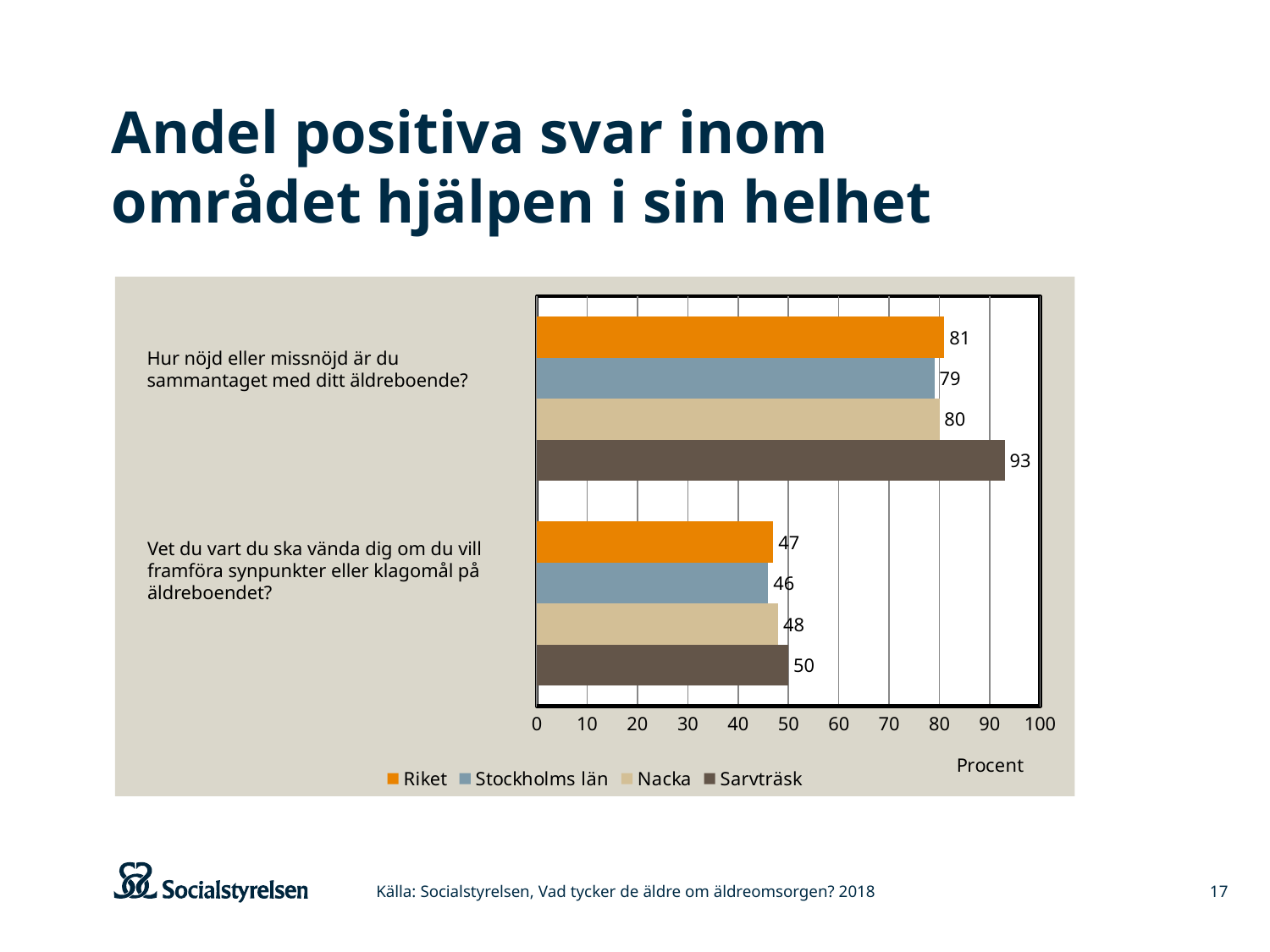
Which series has the highest value on the question 'Hur nöjd eller missnöjd är du sammantaget med ditt äldreboende?' Sarvträsk Which series has the lowest value on the question 'Vet du vart du ska vända dig om du vill framföra synpunkter eller klagomål på äldreboendet?' Stockholms län What is the value for Sarvträsk on the question 'Hur nöjd eller missnöjd är du sammantaget med ditt äldreboende?' 93 Is the Sarvträsk value on the question 'Vet du vart du ska vända dig om du vill framföra synpunkter eller klagomål på äldreboendet?' larger or smaller than the Sarvträsk value on the question 'Hur nöjd eller missnöjd är du sammantaget med ditt äldreboende?' smaller What is the value for Riket on the question 'Vet du vart du ska vända dig om du vill framföra synpunkter eller klagomål på äldreboendet?' 47 What kind of chart is shown on the slide? bar chart What is the difference between the Sarvträsk value and the Riket value on the question 'Hur nöjd eller missnöjd är du sammantaget med ditt äldreboende?' 12 What is the value for Nacka on the question 'Vet du vart du ska vända dig om du vill framföra synpunkter eller klagomål på äldreboendet?' 48 What unit label is shown on the horizontal axis of the chart? Procent How many questions (categories) are shown on the chart? 2 What is the value for Stockholms län on the question 'Hur nöjd eller missnöjd är du sammantaget med ditt äldreboende?' 79 How many series does the legend list? 4